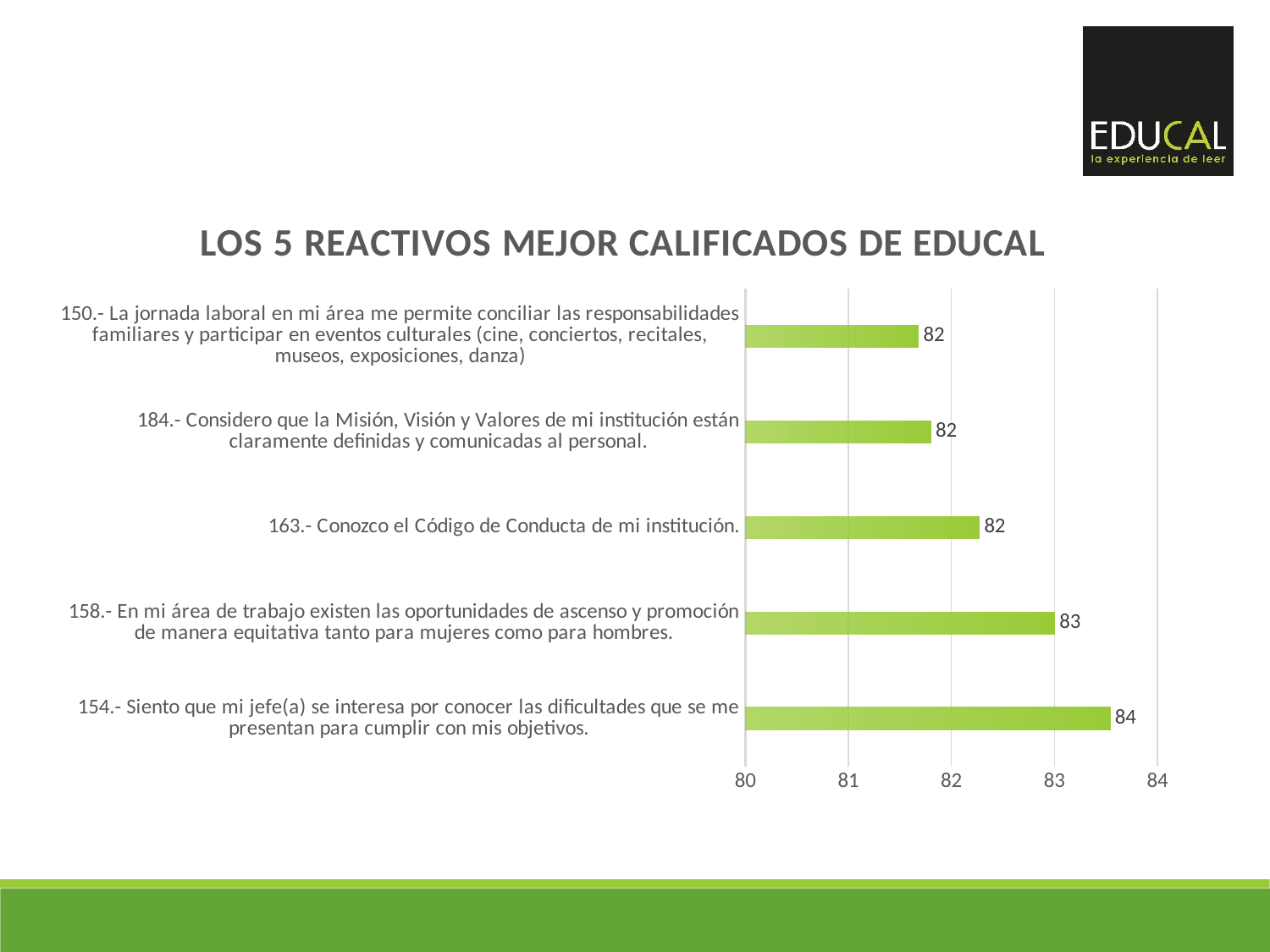
What kind of chart is shown on the slide? bar chart What is the difference between the values for item 154 and item 158? 1 Which has a larger value, item 158 or item 163? 158.- En mi área de trabajo existen las oportunidades de ascenso y promoción de manera equitativa tanto para mujeres como para hombres. Which item has the highest value? 154.- Siento que mi jefe(a) se interesa por conocer las dificultades que se me presentan para cumplir con mis objetivos. What is the difference between the values for item 154 and item 163? 2 What is the title of the chart? LOS 5 REACTIVOS MEJOR CALIFICADOS DE EDUCAL What is the value for item 154 (Siento que mi jefe(a) se interesa por conocer las dificultades que se me presentan para cumplir con mis objetivos)? 84 Is the value for item 154 greater or less than 83? greater What is the value for item 158 (En mi área de trabajo existen las oportunidades de ascenso y promoción de manera equitativa tanto para mujeres como para hombres)? 83 How many items (bars) are shown in the chart? 5 What is the value for item 163 (Conozco el Código de Conducta de mi institución)? 82